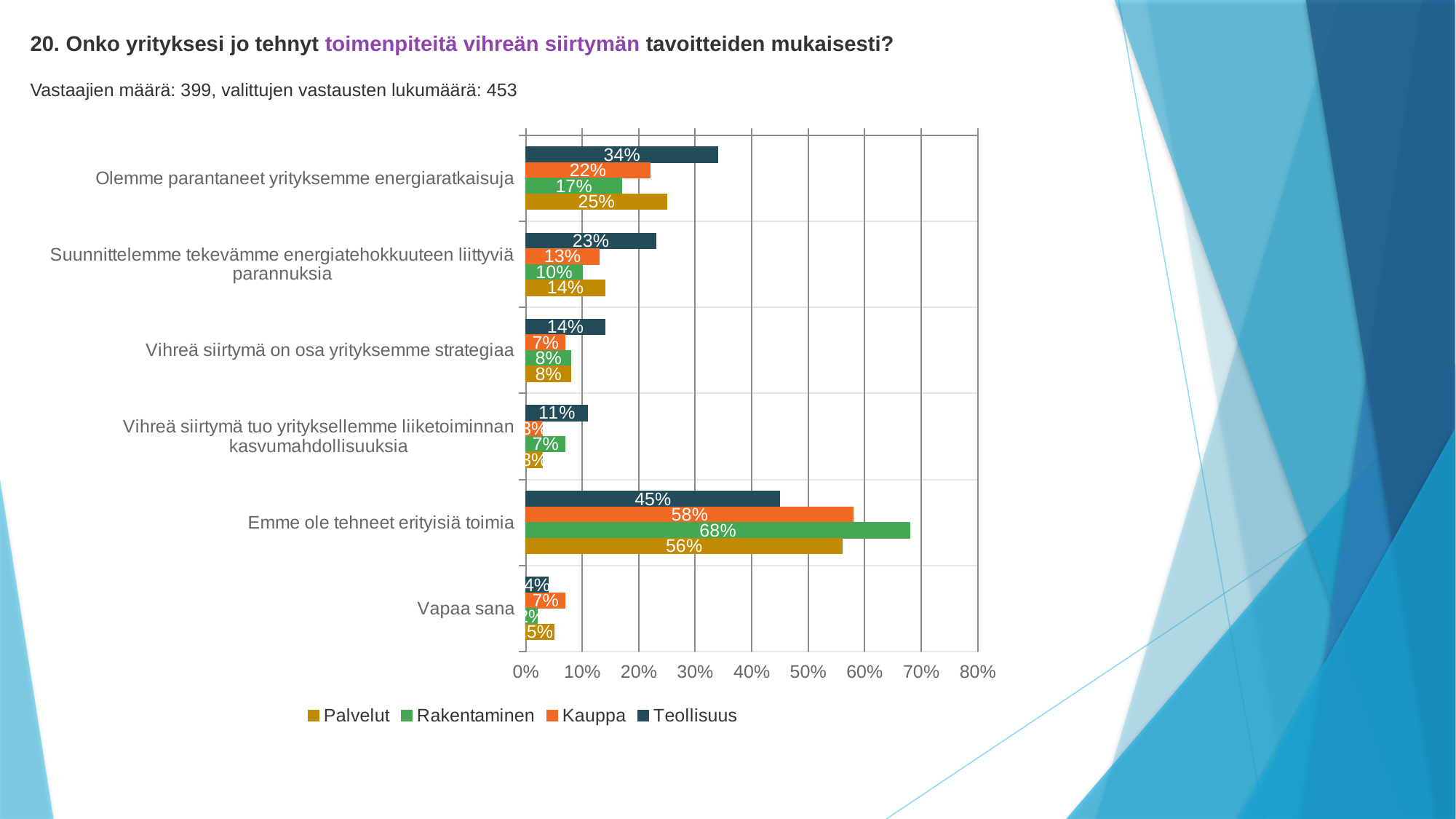
In the category 'Vihreä siirtymä on osa yrityksemme strategiaa', which is larger: the value for Teollisuus or the value for Kauppa? Teollisuus Which series has the lowest value in the category 'Olemme parantaneet yrityksemme energiaratkaisuja'? Rakentaminen What kind of chart is shown on the slide? bar chart What is the value for Rakentaminen in the category 'Emme ole tehneet erityisiä toimia'? 68% What is the value for Teollisuus in the category 'Olemme parantaneet yrityksemme energiaratkaisuja'? 34% How many categories are shown on the vertical axis of the chart? 6 Which series has the highest value in the category 'Emme ole tehneet erityisiä toimia'? Rakentaminen Is the value for Teollisuus in the category 'Emme ole tehneet erityisiä toimia' greater or less than 40%? greater What is the difference between the Kauppa and Rakentaminen values in the category 'Emme ole tehneet erityisiä toimia'? 10% How many series does the legend list? 4 Which legend entry is shown in orange? Kauppa What is the value for Palvelut in the category 'Suunnittelemme tekevämme energiatehokkuuteen liittyviä parannuksia'? 14%